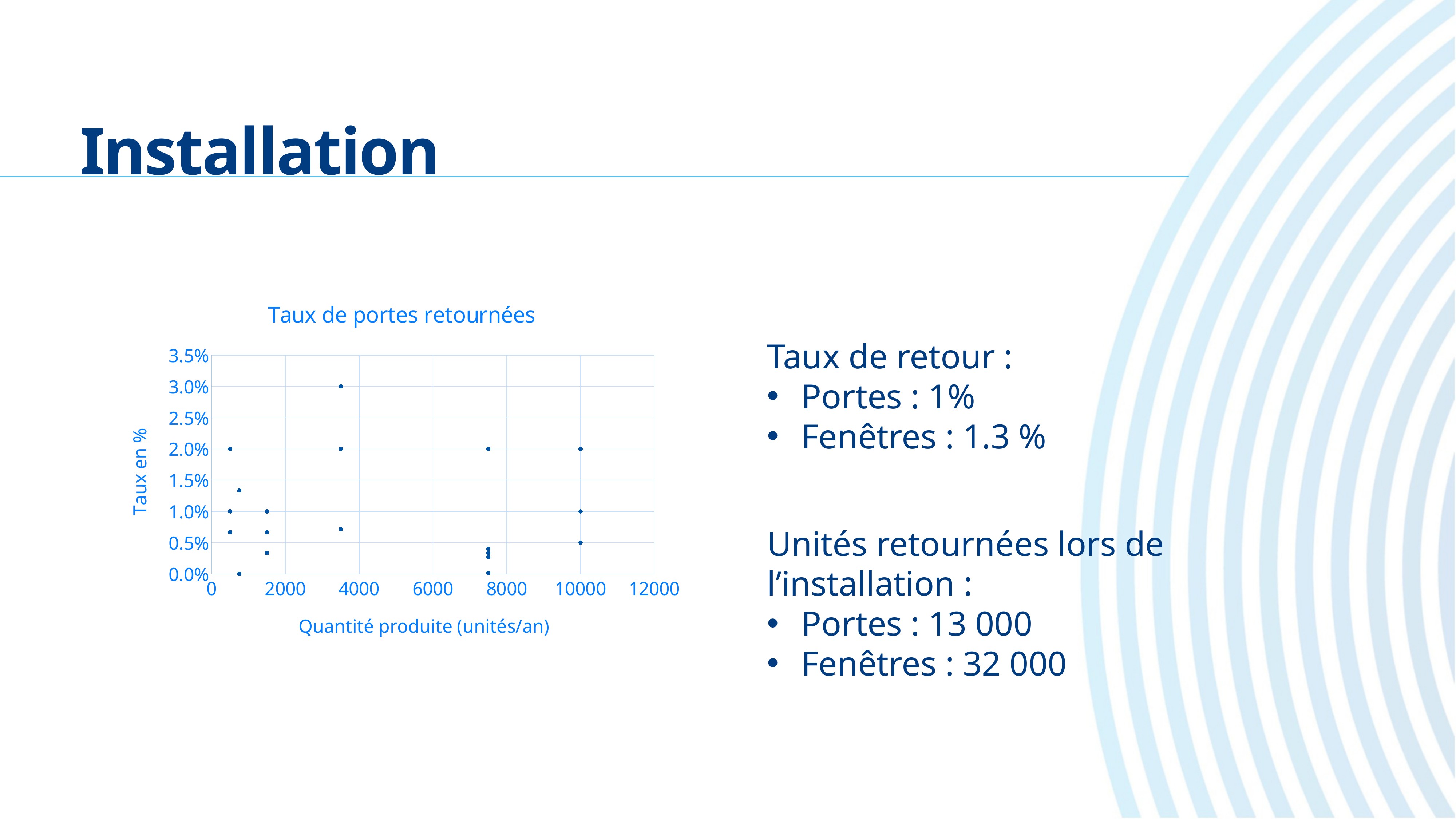
What is the highest value shown on the x axis of the chart? 12000 What is the lowest return rate plotted on the chart? 0.0% What is the label of the x axis of the chart? Quantité produite (unités/an) What kind of chart is shown on the slide? scatter chart Is the highest plotted return rate greater or less than 2.5%? greater Does the chart show a legend? No Is the highest return rate plotted at a production quantity of about 3500 units/an greater or less than 2.5%? greater Is the highest return rate plotted at a production quantity of about 10000 units/an greater or less than 2.5%? less What is the highest value shown on the y axis of the chart? 3.5% What is the title of the chart? Taux de portes retournées What is the highest return rate plotted on the chart? 3.0%